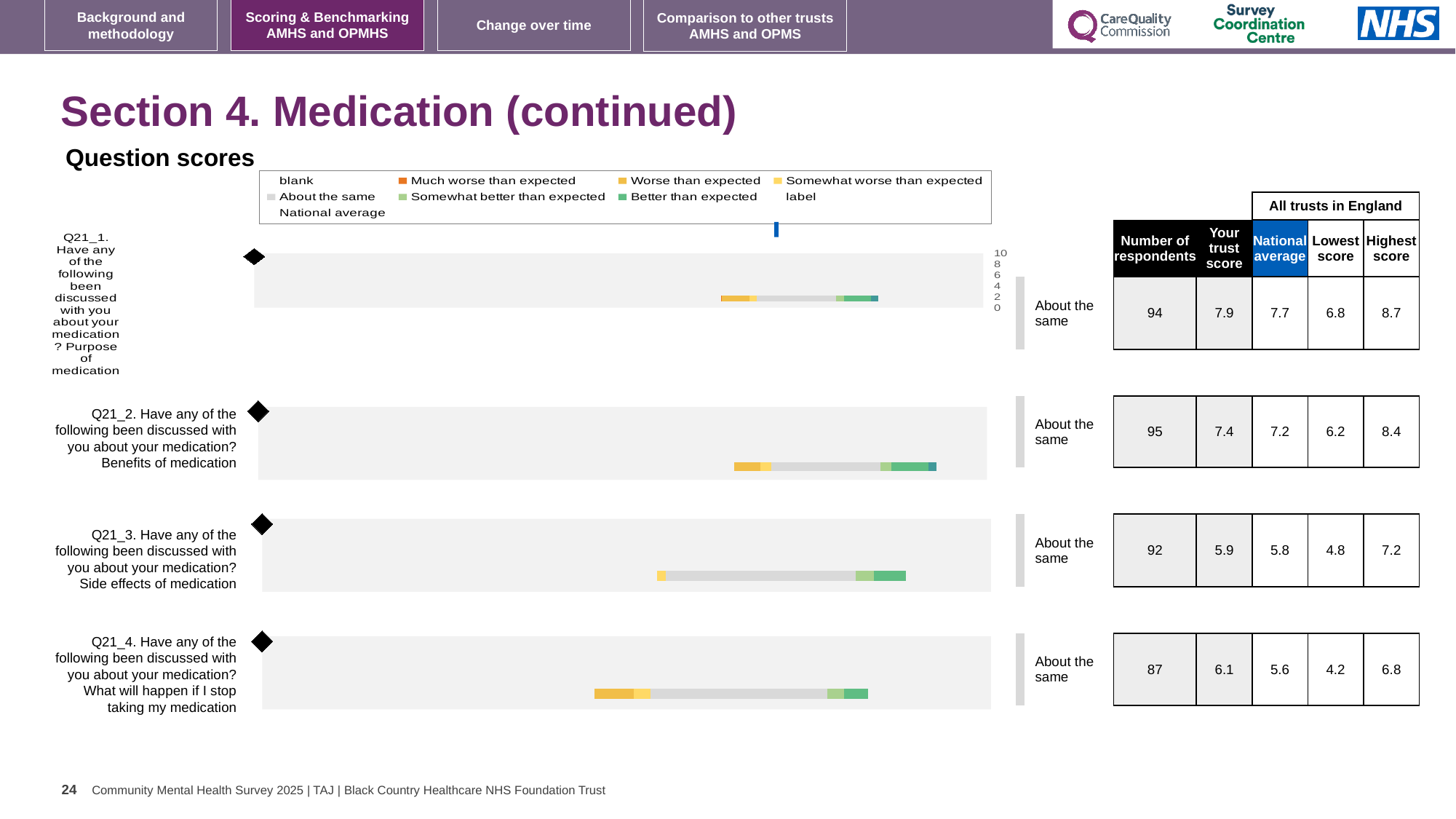
How many question charts (Q21_1 to Q21_4) are shown on the slide? 4 What kind of chart is used to show the question scores on this slide? bar chart For the Q21_1 chart (Purpose of medication), what is the 'Your trust score' shown in the table? 7.9 Which question has the highest 'Your trust score' on this slide? Q21_1 (Purpose of medication) What benchmark category is shown next to each of the four question charts? About the same For Q21_4, what is the difference between 'Your trust score' and the National average? 0.5 Which question has the lowest 'Your trust score' on this slide? Q21_3 (Side effects of medication) For the Q21_4 chart (What will happen if I stop taking my medication), how many respondents are listed? 87 For the Q21_2 chart (Benefits of medication), what is the Highest score among all trusts in England? 8.4 In the chart legend, which entry is shown in orange? Much worse than expected For the Q21_3 chart (Side effects of medication), what is the National average shown in the table? 5.8 For Q21_2, which is larger: 'Your trust score' or the National average? Your trust score